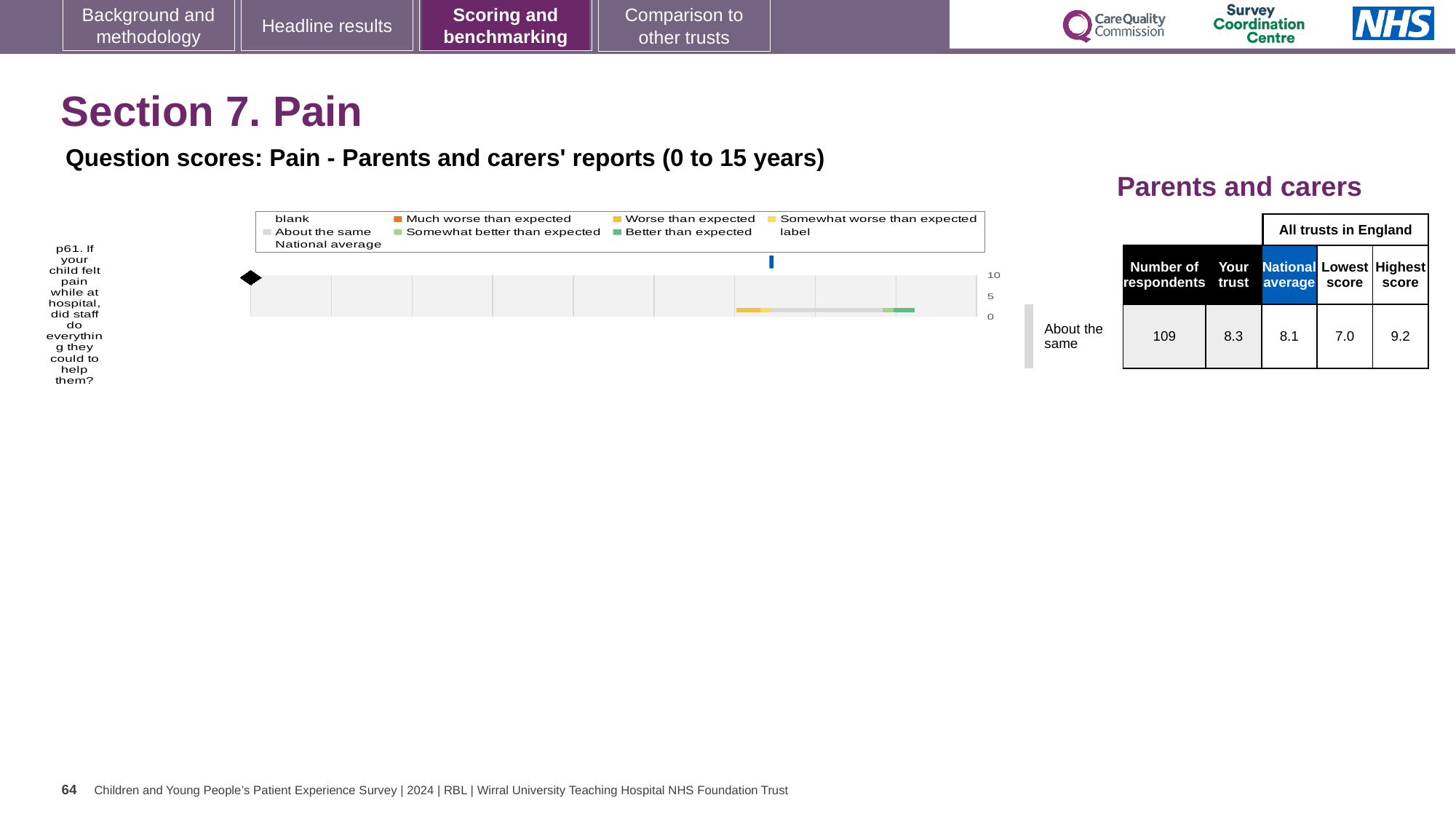
How many respondents answered question p61? 109 What is the national average score for question p61? 8.1 Which is larger for question p61: the 'Your trust' score or the national average? Your trust How many questions (categories) are plotted in the chart? 1 Is the national average marker for question p61 greater or less than 5 on the axis? greater What is the difference between the highest score and the lowest score for question p61? 2.2 What is the highest score among all trusts in England for question p61? 9.2 What is the lowest score among all trusts in England for question p61? 7.0 What kind of chart is shown on the slide? bar chart Which legend entry is shown in green (the darker green marker)? Better than expected What is the 'Your trust' score for question p61? 8.3 What is the highest value shown on the chart's axis? 10